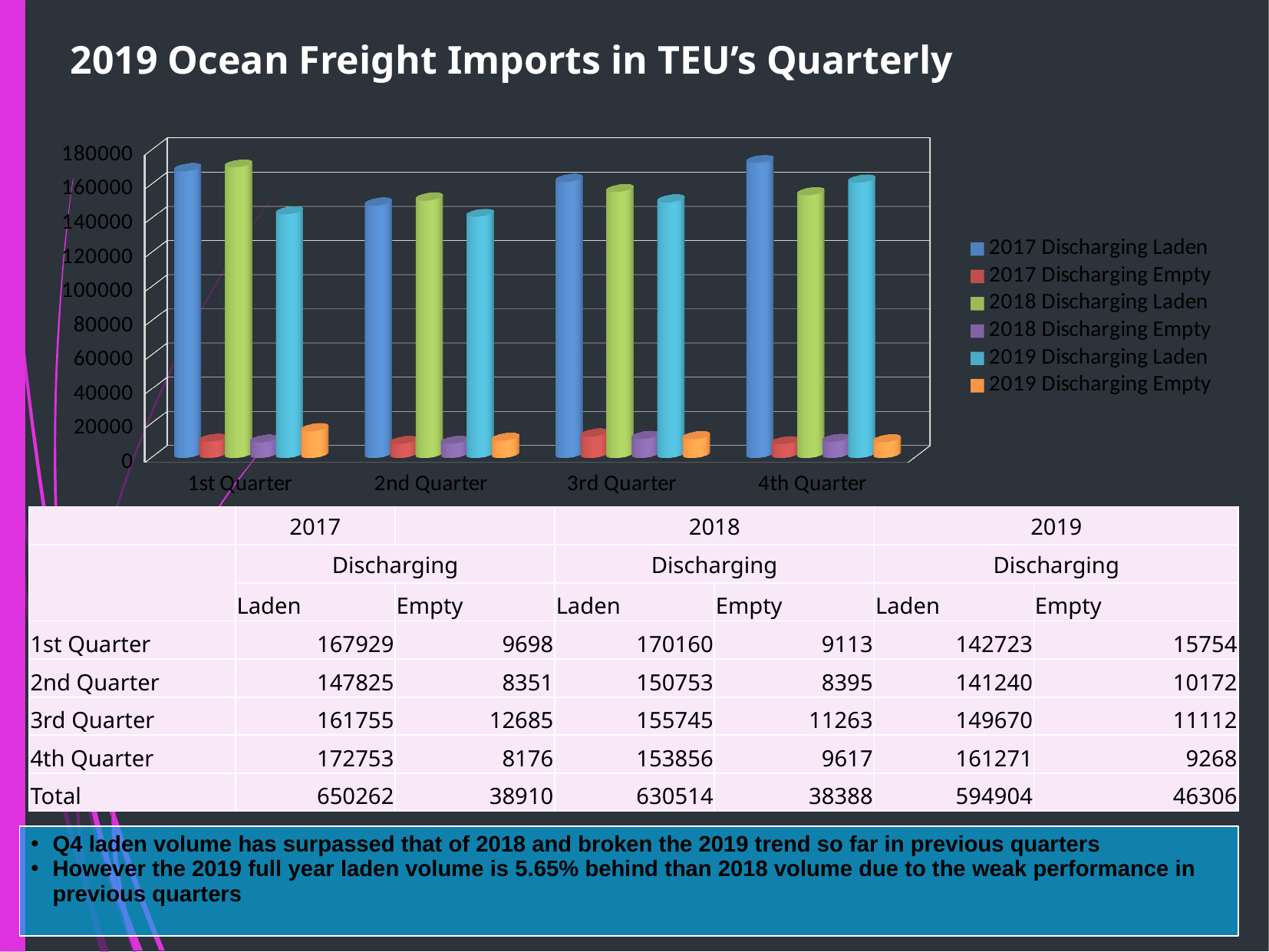
What is the title of the slide containing the chart? 2019 Ocean Freight Imports in TEU's Quarterly What is the 2018 Discharging Empty value for the 4th Quarter? 9617 What is the difference between the 2018 Discharging Laden and 2019 Discharging Laden values in the 1st Quarter? 27437 How many quarters are shown on the x axis of the chart? 4 How many series does the chart legend list? 6 What is the 2017 Discharging Empty value for the 3rd Quarter? 12685 In which quarter is the 2019 Discharging Empty value highest? 1st Quarter What kind of chart is shown on the slide? bar chart What is the 2019 Discharging Laden value for the 1st Quarter? 142723 In which quarter is the 2017 Discharging Laden value highest? 4th Quarter In the 3rd Quarter, which is larger: 2017 Discharging Laden or 2018 Discharging Laden? 2017 Discharging Laden Is the 2019 Discharging Laden value for the 2nd Quarter greater or less than 160000? less